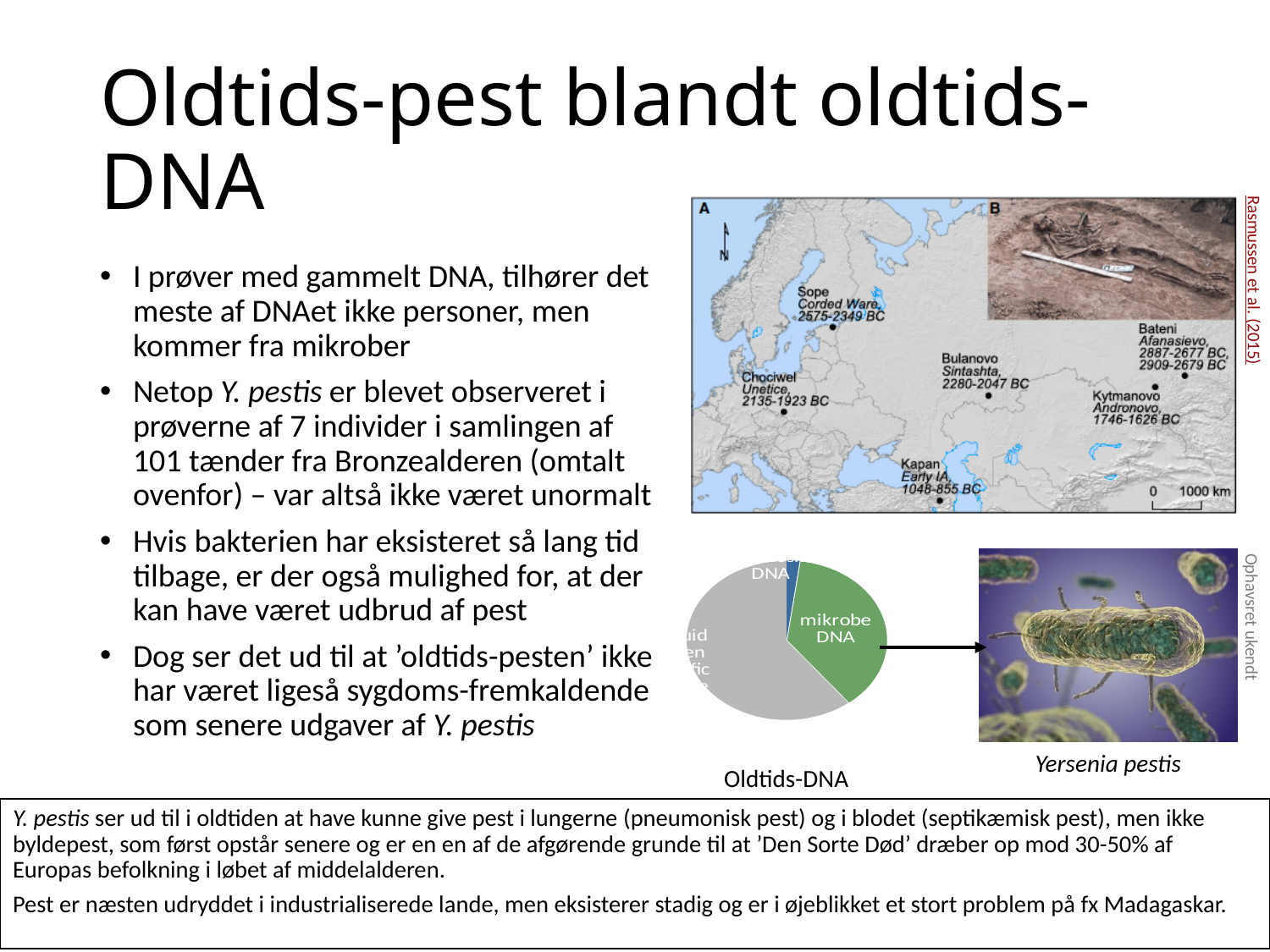
What colour is the 'mikrobe DNA' slice in the pie chart? green Which is larger in the pie chart, the grey slice or the 'mikrobe DNA' slice? the grey slice What is the caption/title under the pie chart? Oldtids-DNA Which slice of the pie chart is the smallest? the blue slice How many slices does the pie chart have? 3 What kind of chart is shown below the map on the slide? pie chart Is the 'mikrobe DNA' slice the largest slice in the pie chart? No